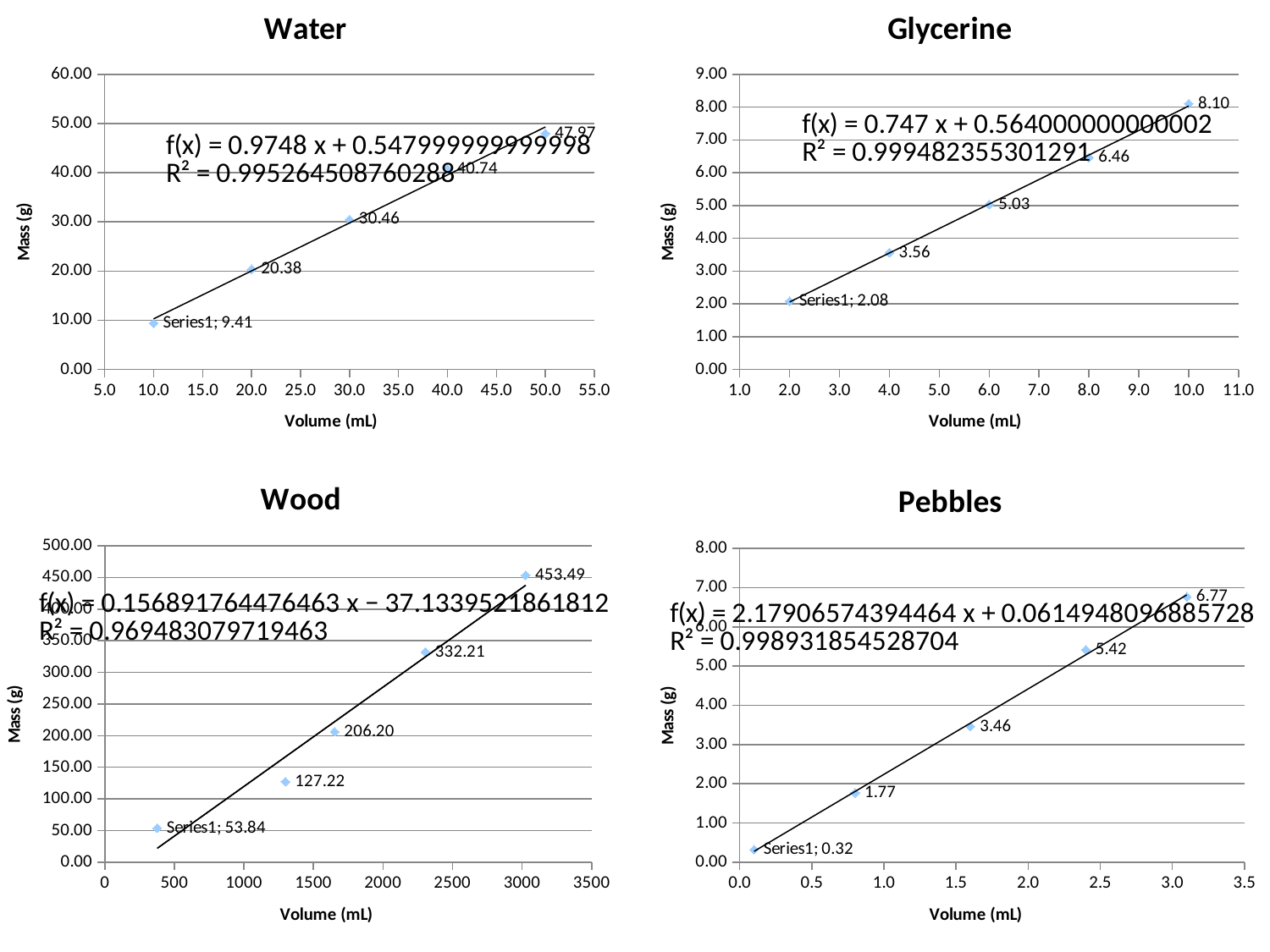
In the Wood chart, what is the mass of the highest data point? 453.49 In the Glycerine chart, what is the difference in mass between the highest point (8.10) and the lowest point (2.08)? 6.02 In the Water chart, what is the mass of the highest data point? 47.97 What kind of chart is the Wood chart? scatter chart with a trendline In the Pebbles chart, is the mass of the point at about 1.6 mL greater or less than 3.00? greater What is the y-axis label on the Water chart? Mass (g) In the Pebbles chart, what is the mass of the lowest data point? 0.32 What is the R² value shown on the Glycerine chart? 0.999482355301291 How many data points are plotted in the Glycerine chart? 5 In the Wood chart, which is larger: the point labelled 206.20 or the point labelled 127.22? 206.20 In the Pebbles chart, do the mass values rise or fall as volume increases? rise In the Water chart, what is the mass of the lowest data point? 9.41